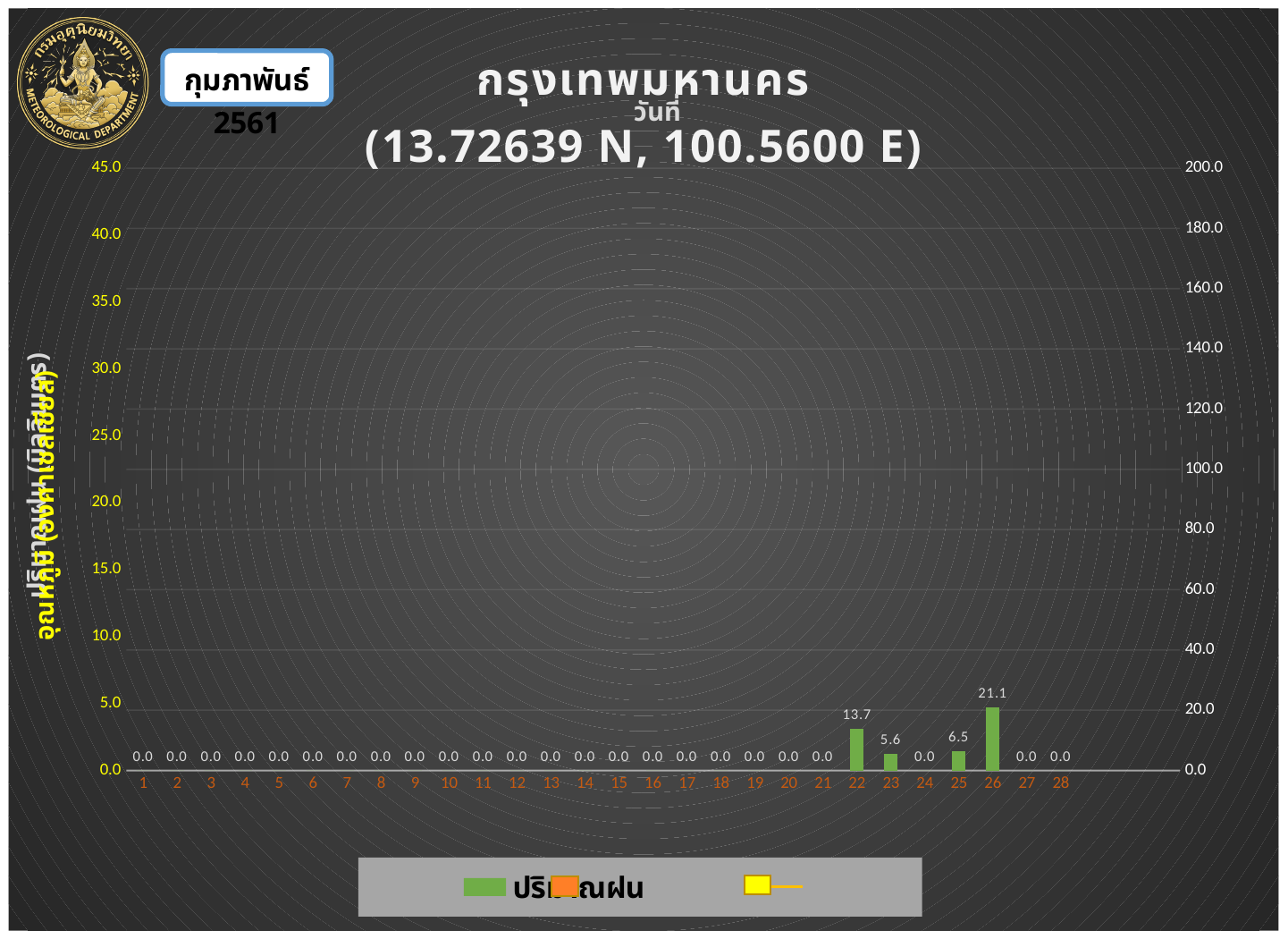
What is the total rainfall for days 22 and 23 combined? 19.3 What is the rainfall value shown for day 23? 5.6 What kind of chart is shown on the slide? bar chart What is the difference between the rainfall values for day 26 and day 22? 7.4 How many days are shown on the x axis? 28 Which day has the highest rainfall value? 26 What is the rainfall value shown for day 22? 13.7 What is the rainfall value shown for day 26? 21.1 Which has the larger rainfall value, day 23 or day 25? day 25 What is the rainfall value shown for day 25? 6.5 Is the rainfall value for day 26 greater or less than 20? greater What is the rainfall value shown for day 10? 0.0